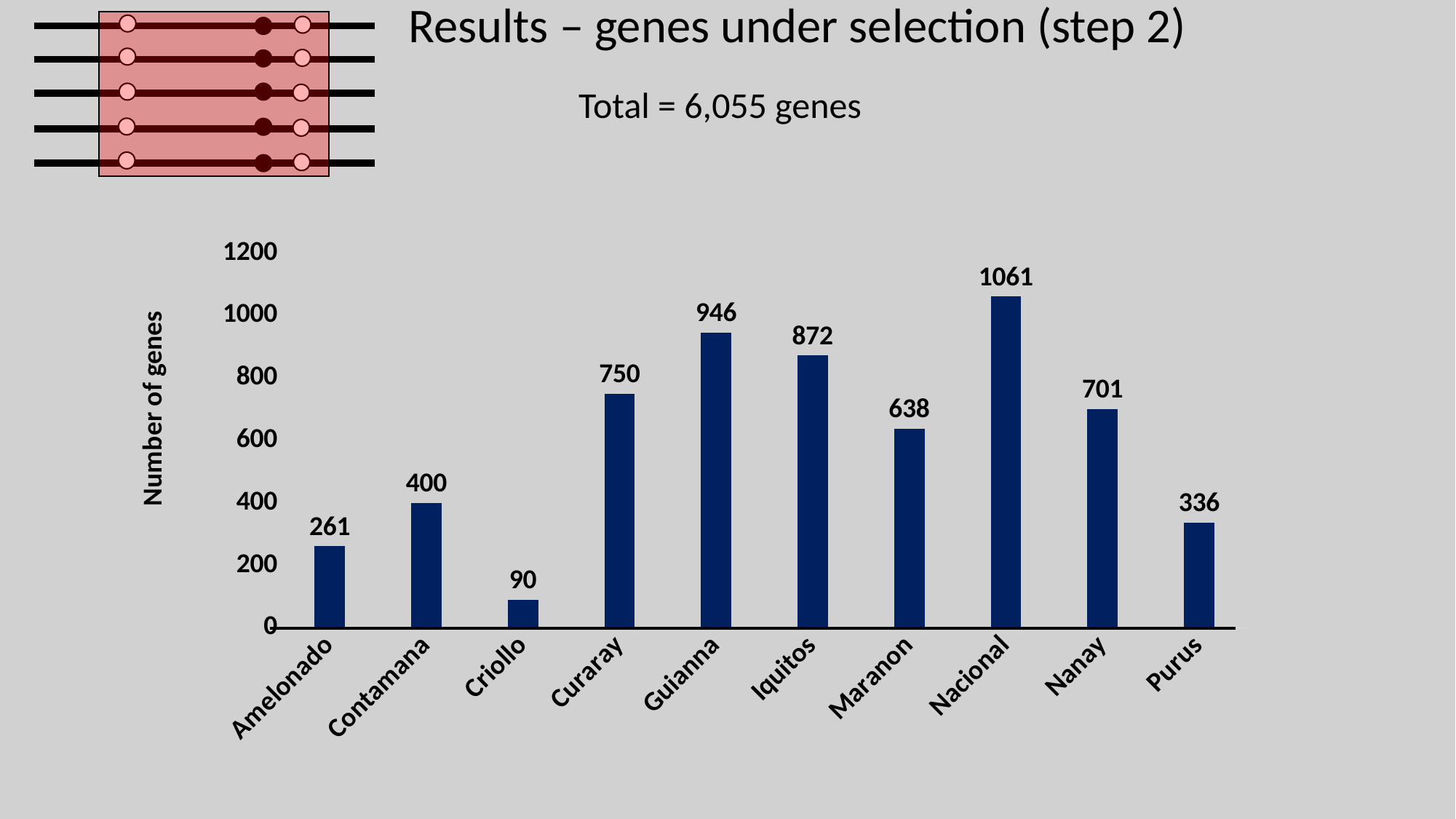
Which has more genes, Iquitos or Curaray? Iquitos What is the difference in number of genes between Nacional and Nanay? 360 What is the number of genes for Maranon? 638 How many categories are shown on the x axis? 10 Which category has the lowest number of genes? Criollo Which category has the highest number of genes? Nacional What is the number of genes for Guianna? 946 What is the label of the vertical axis? Number of genes What kind of chart is shown on the slide? bar chart Is the value for Purus greater or less than 400? less What is the number of genes for Criollo? 90 What is the difference in number of genes between Contamana and Amelonado? 139